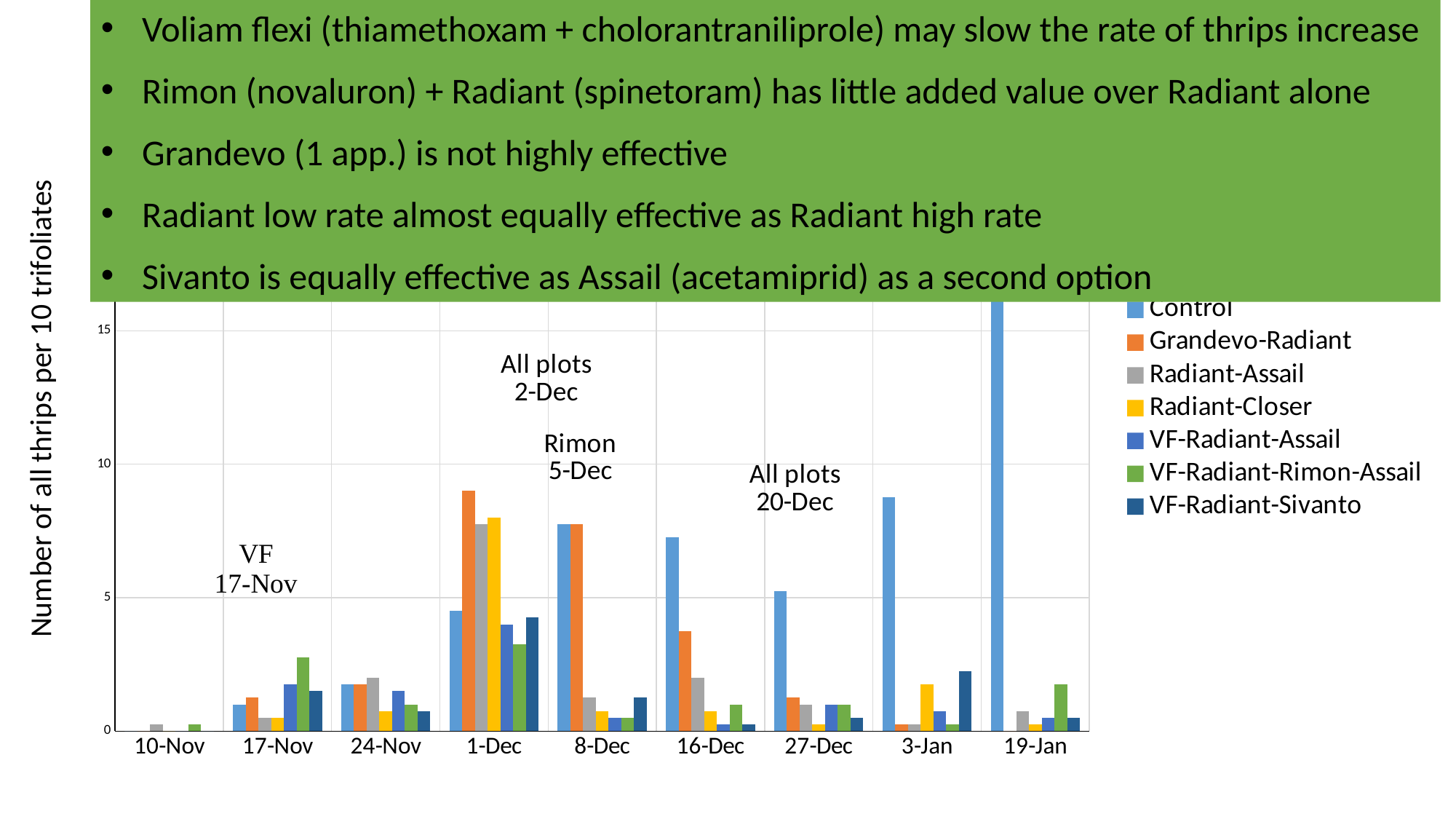
On which date does the Control series reach its highest value? 19-Jan How many series does the chart's legend list? 7 What kind of chart is shown on the slide? bar chart Is the value for Control on 19-Jan greater or less than 15? greater Which series has the highest value on 1-Dec? Grandevo-Radiant How many date categories are shown on the x axis of the chart? 9 Is the value for Grandevo-Radiant on 1-Dec greater or less than 5? greater Is the value for Control on 3-Jan greater or less than 5? greater On 1-Dec, which is larger: the Grandevo-Radiant value or the Control value? Grandevo-Radiant On 16-Dec, which is larger: the Control value or the Grandevo-Radiant value? Control What is the label on the chart's vertical axis? Number of all thrips per 10 trifoliates